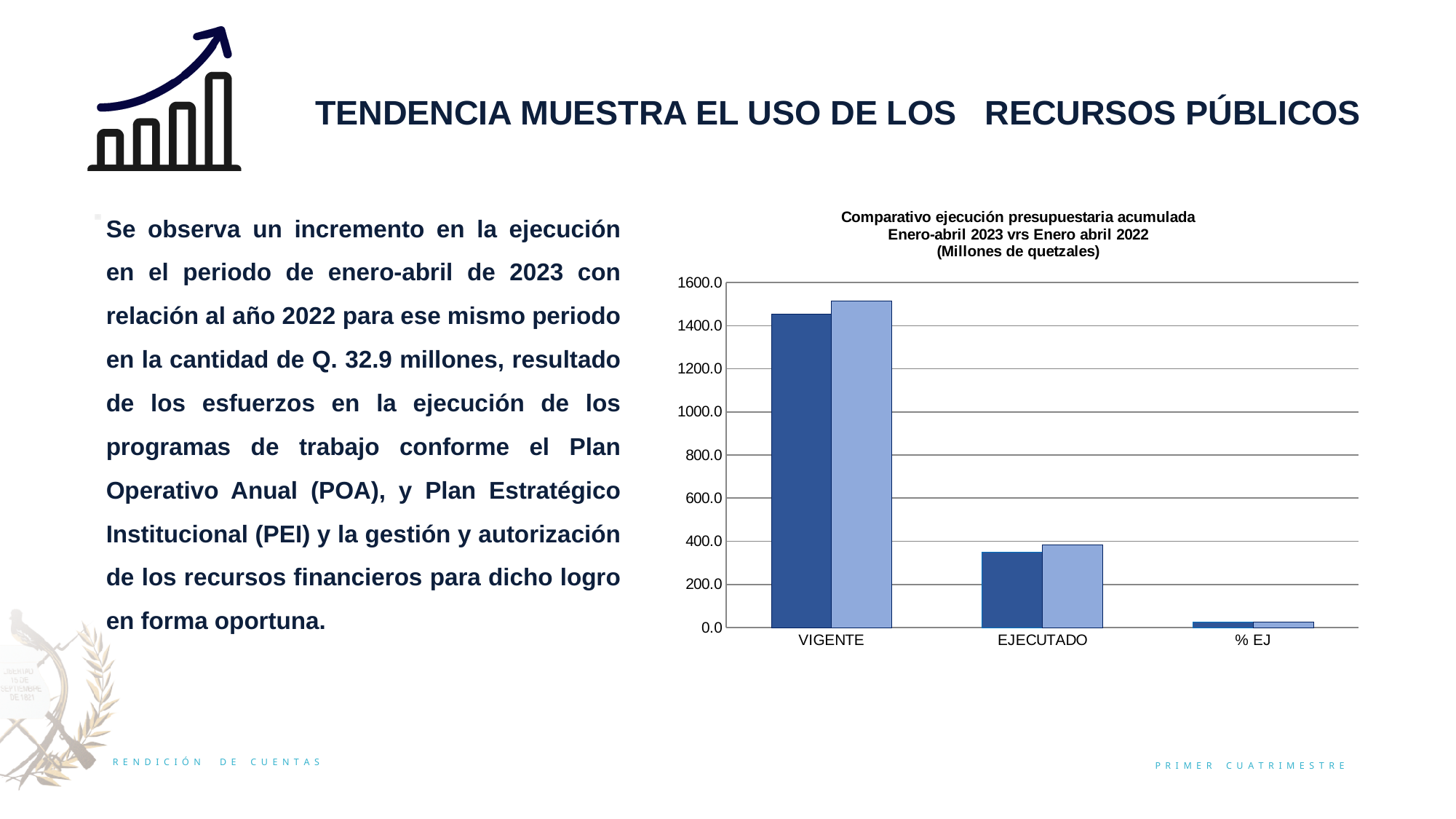
Which category has the tallest bars in the chart? VIGENTE Is the value for % EJ greater or less than 200? less Is the value of the dark blue bar for EJECUTADO greater or less than 400? less Is the value of the light blue bar for VIGENTE greater or less than 1600? less Which category has the shortest bars in the chart? % EJ What unit does the chart title say the values are in? Millones de quetzales How many categories are shown on the x axis of the chart? 3 For VIGENTE, which bar is taller, the dark blue one or the light blue one? The light blue one What kind of chart is shown on the slide? Bar chart How many bars are plotted for each category in the chart? 2